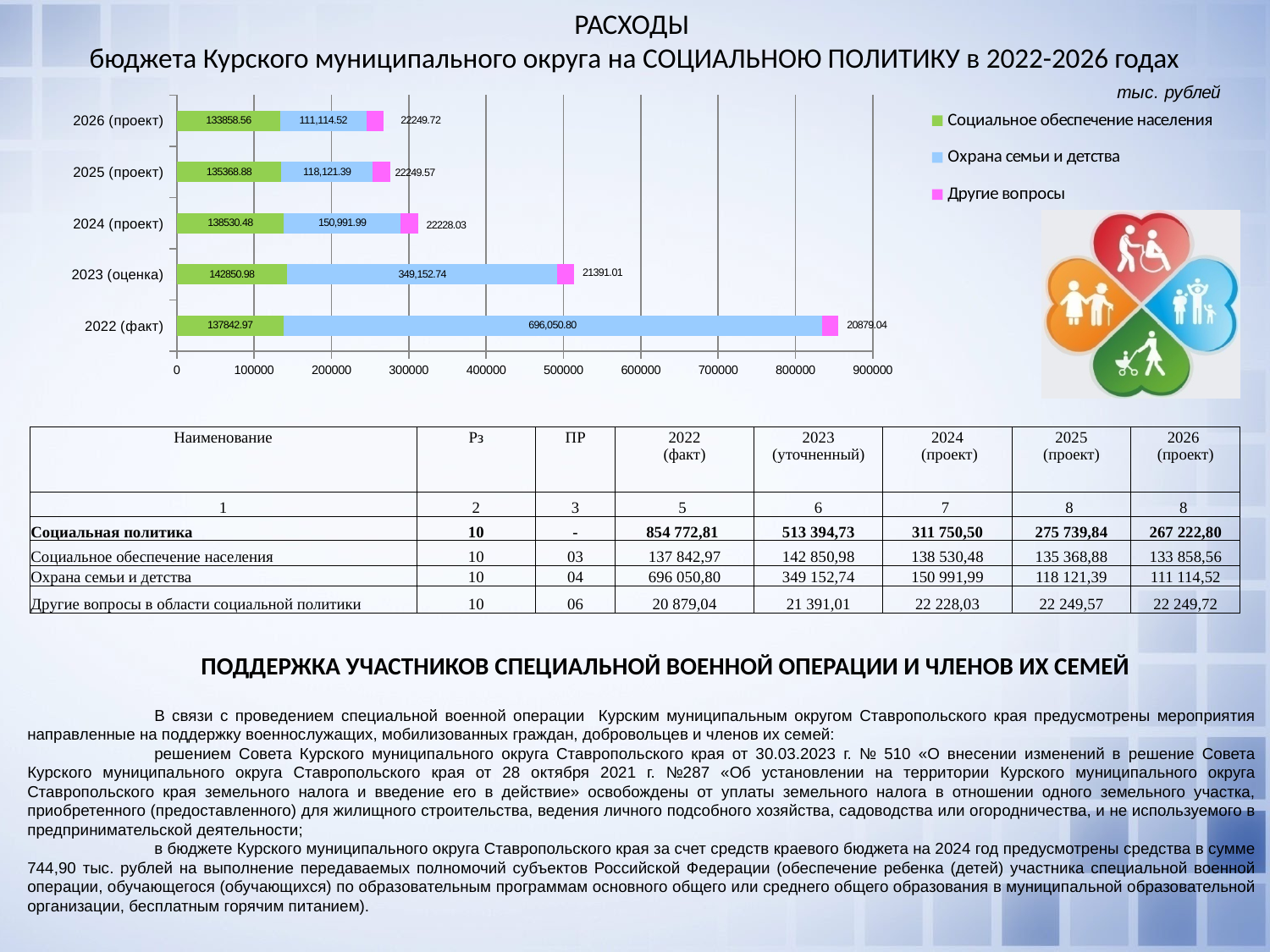
What is the difference between Охрана семьи и детства for 2022 (факт) and 2023 (оценка)? 346,898.06 How many year categories are plotted in the chart? 5 How many series does the chart legend list? 3 What is the total of the stacked bar for 2024 (проект)? 311,750.50 What is the value of Другие вопросы for 2026 (проект) in the chart? 22249.72 What kind of chart is shown on the slide? stacked bar chart Which is larger: Охрана семьи и детства for 2023 (оценка) or for 2024 (проект)? 2023 (оценка) Which year has the lowest value for Другие вопросы? 2022 (факт) Does the total stacked bar for 2022 (факт) extend beyond 800000 on the axis? Yes What is the value of Охрана семьи и детства for 2022 (факт) in the chart? 696,050.80 What is the value of Социальное обеспечение населения for 2023 (оценка) in the chart? 142850.98 Which year has the highest value for Охрана семьи и детства? 2022 (факт)